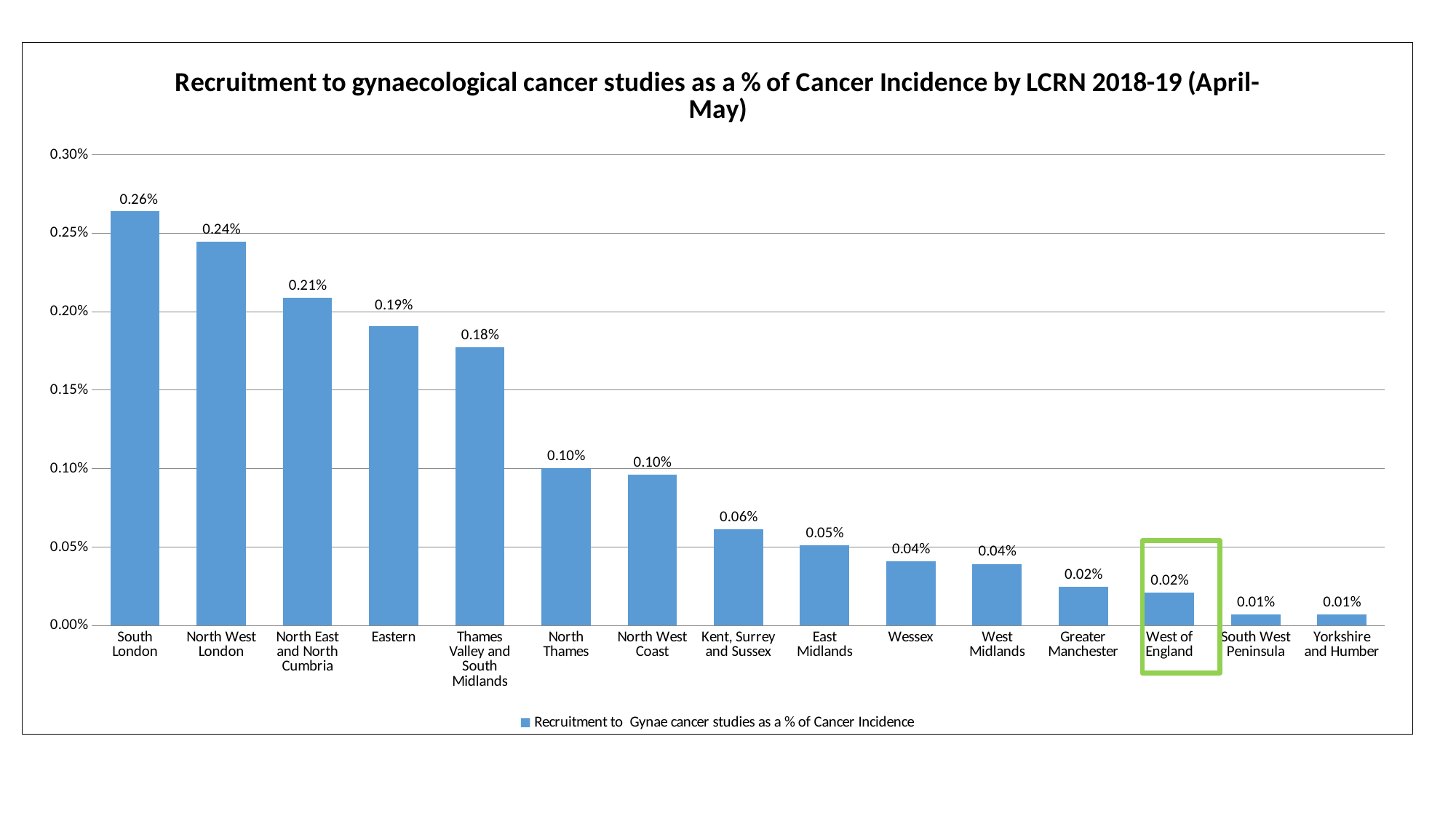
Which LCRN has the highest recruitment as a % of cancer incidence? South London Is the value for Thames Valley and South Midlands greater or less than 0.15%? greater What is the value for Kent, Surrey and Sussex? 0.06% What is the value for South London? 0.26% Which is larger, the value for Eastern or the value for North Thames? Eastern What is the difference between the values for South London and North West London? 0.02% How many LCRNs are shown on the x axis? 15 What kind of chart is shown on the slide? Bar chart What is the value for West of England? 0.02% How many series does the legend list? 1 Which LCRN's bar is highlighted with a green box? West of England What is the value for Thames Valley and South Midlands? 0.18%